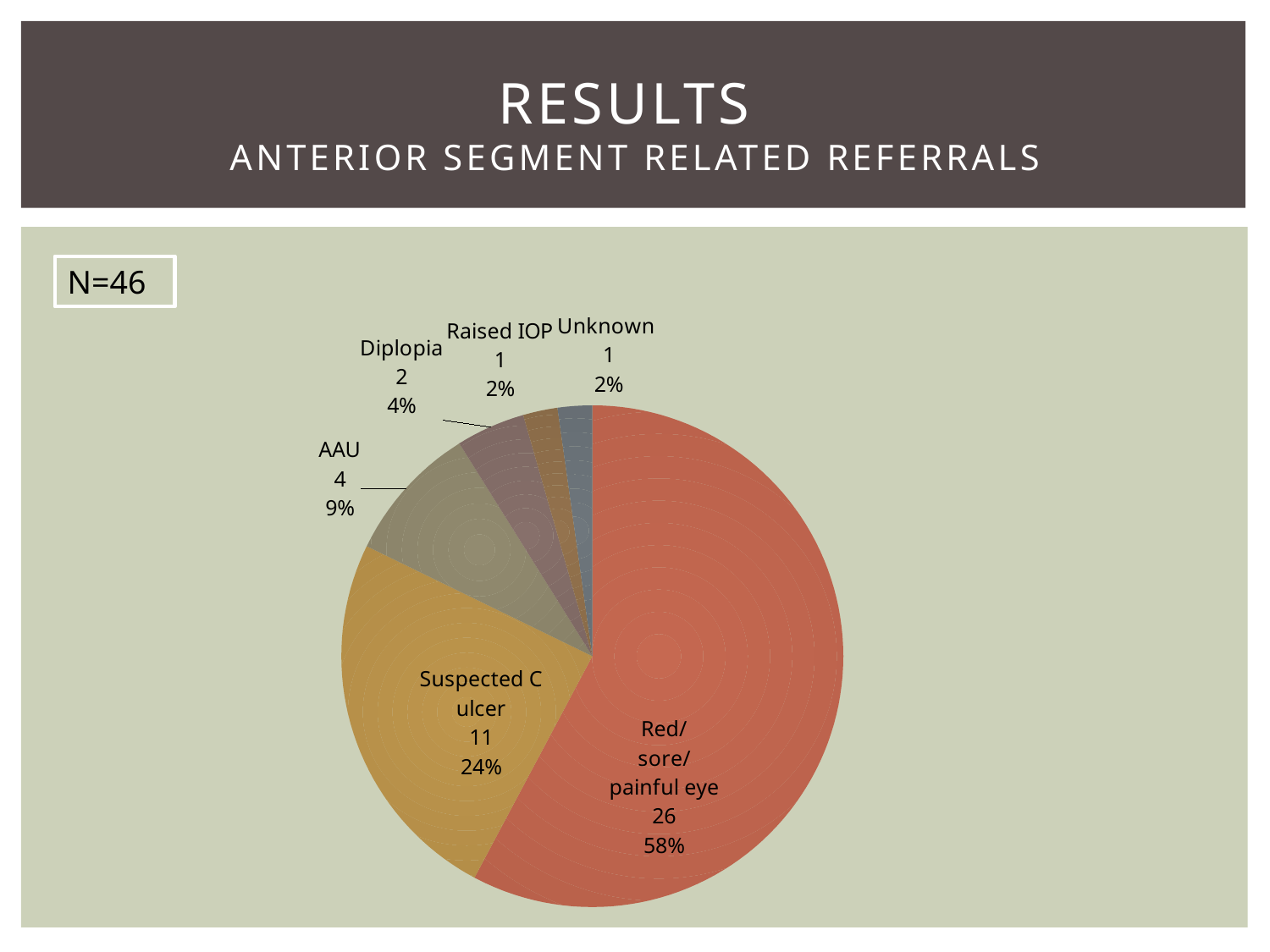
How many categories are shown in the pie chart? 6 Which is larger, the AAU slice or the Diplopia slice? AAU What share of the pie does Red/sore/painful eye represent? 58% What percentage of referrals is attributed to Diplopia? 4% What type of chart is shown on the slide? pie chart How many referrals are in the Raised IOP category? 1 Which category has the largest slice of the pie? Red/sore/painful eye What is the difference in referral count between Red/sore/painful eye and Suspected C ulcer? 15 How many referrals are in the AAU category? 4 What percentage of referrals does Suspected C ulcer account for? 24% What is the total number of referrals (N) stated on the slide? N=46 How many referrals are in the Red/sore/painful eye category? 26